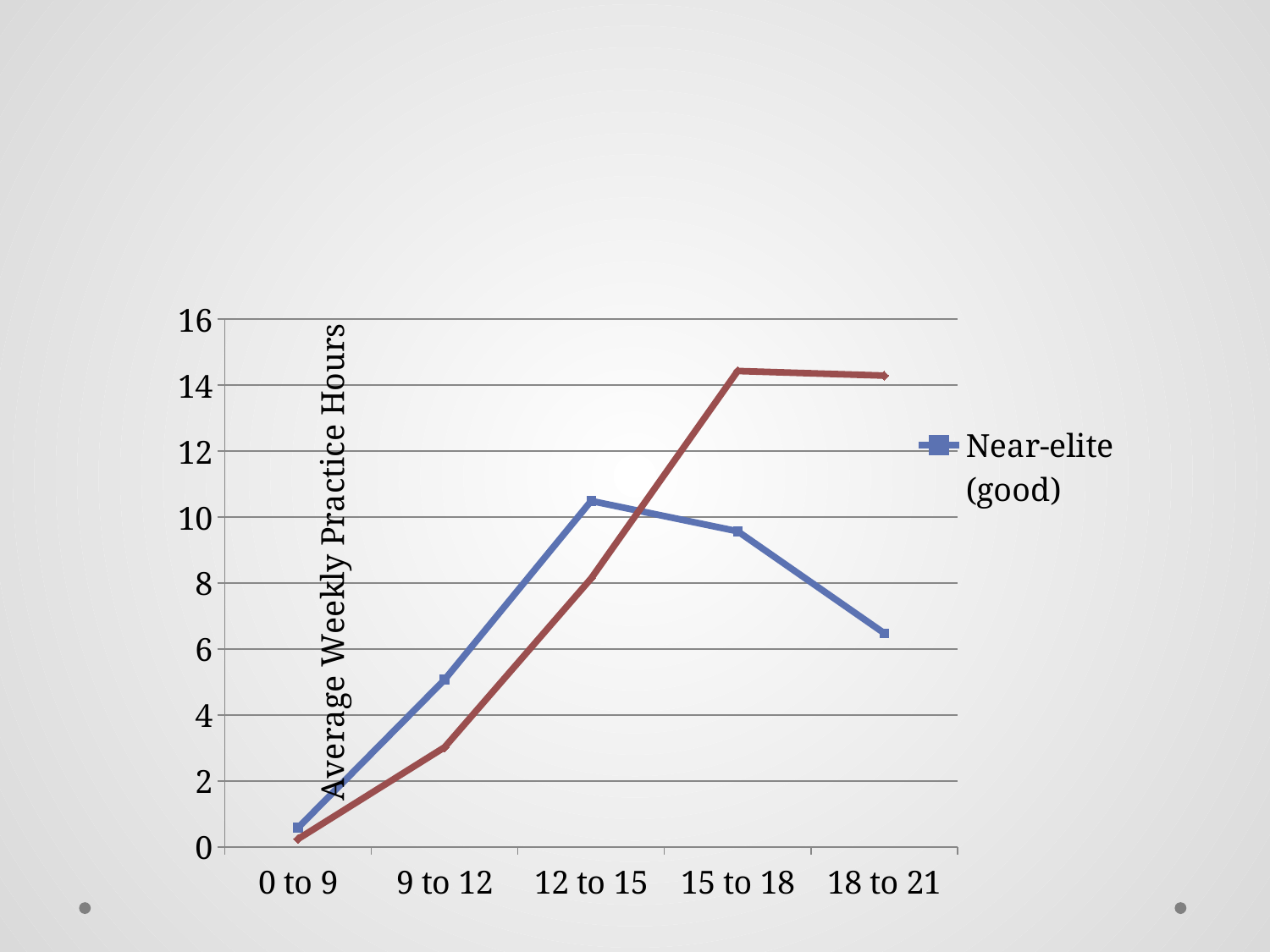
Does the Near-elite (good) line rise or fall from 12 to 15 to 18 to 21? fall How many categories are shown on the x axis? 5 What kind of chart is shown on the slide? line chart For which category is the Near-elite (good) value highest? 12 to 15 Is the Near-elite (good) value for 0 to 9 greater or less than 2? less For which category is the Near-elite (good) value lowest? 0 to 9 Is the Near-elite (good) value for 18 to 21 greater or less than 8? less How many series does the legend list? 1 What is the title of the vertical axis? Average Weekly Practice Hours Which is larger for Near-elite (good): the value for 9 to 12 or the value for 15 to 18? 15 to 18 Is the Near-elite (good) value for 12 to 15 greater or less than 10? greater What series name is shown in the legend? Near-elite (good)